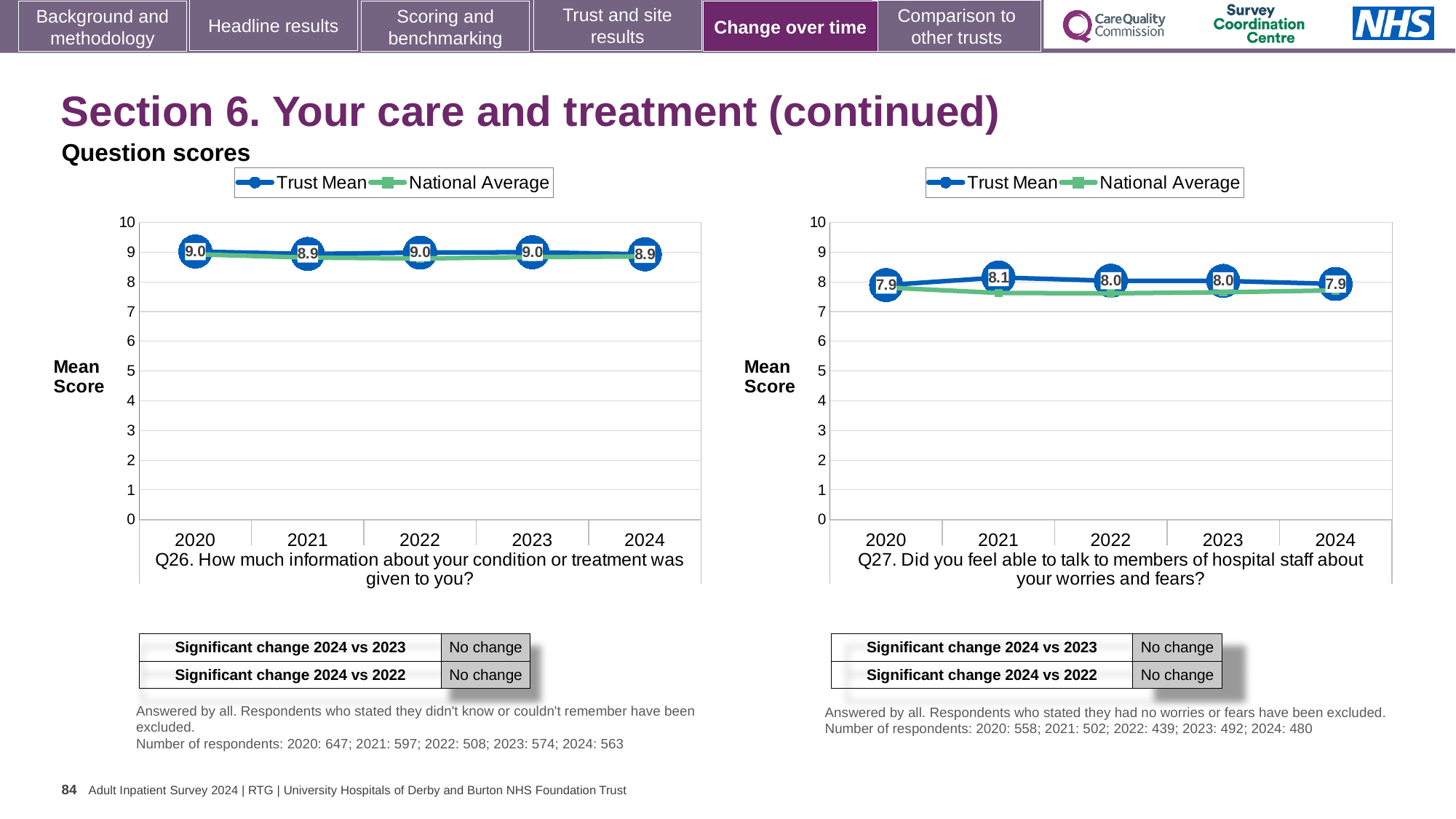
How many years are plotted on the x axis of the Q26 chart on the left? 5 In the Q26 chart on the left, is the Trust Mean score for 2022 larger or smaller than the score for 2021? larger What kind of chart is the Q26 chart on the left? Line chart In the Q27 chart on the right, which year has the highest Trust Mean score? 2021 How many series does the legend of the Q27 chart on the right list? 2 In the Q27 chart on the right, what is the difference between the Trust Mean scores for 2021 and 2020? 0.2 In the Q27 chart on the right, what is the Trust Mean score for 2024? 7.9 In the Q26 chart on the left, what is the Trust Mean score for 2020? 9.0 What are the two series named in the legend of the Q26 chart on the left? Trust Mean and National Average In the Q26 chart on the left, what is the Trust Mean score for 2024? 8.9 In the Q27 chart on the right, what is the Trust Mean score for 2021? 8.1 In the Q27 chart on the right, is the National Average value for 2021 greater or less than 9? less